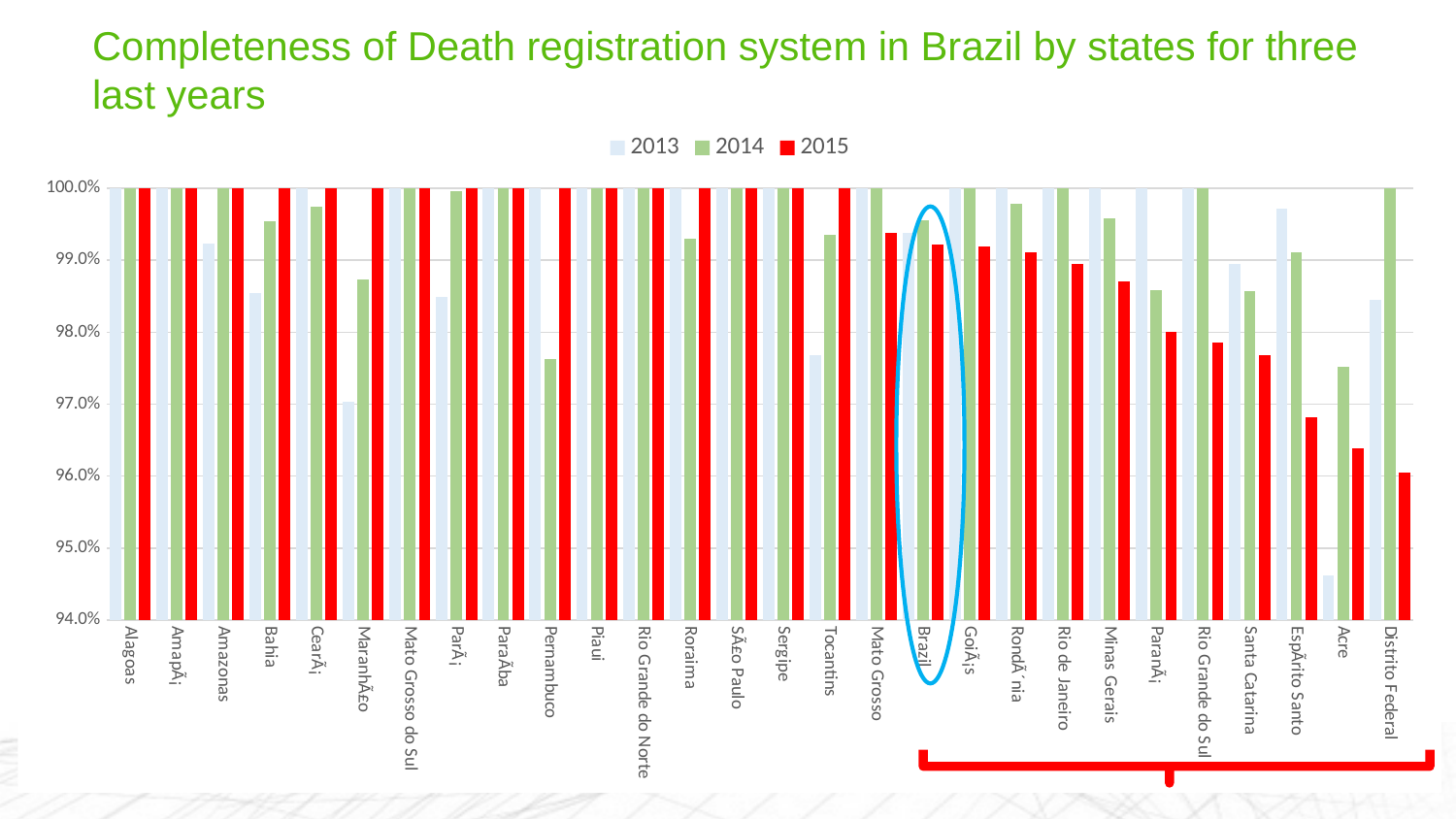
How many series does the legend list? 3 Which series is shown in red? 2015 How many categories are shown along the x axis? 28 Which category has the lowest 2013 value? Acre Is the 2015 value for Acre greater or less than 97.0%? less What is the 2015 value for Alagoas? 100.0% Is the 2013 value for Acre greater or less than 95.0%? less What kind of chart is shown on the slide? Bar chart What is the 2014 value for Distrito Federal? 100.0% Which category has the lowest 2015 value? Distrito Federal Is the 2014 value for Pernambuco greater or less than 98.0%? less Which is larger, the 2014 value for Acre or the 2014 value for Distrito Federal? Distrito Federal